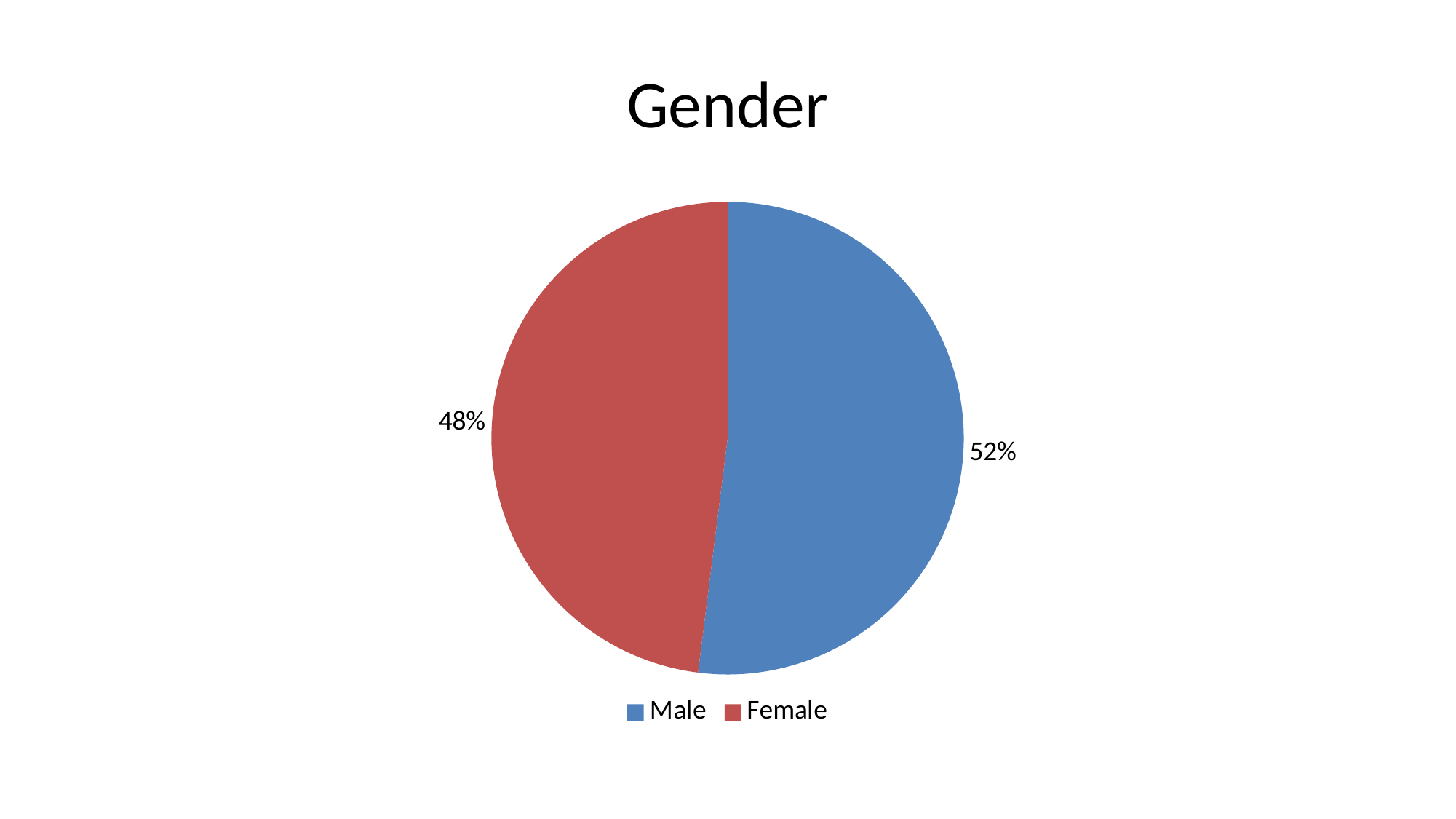
What percentage of the pie is Female? 48% Which is larger, the Male share or the Female share? Male What is the title of the chart? Gender Which category has the smallest share of the pie? Female What is the difference in percentage points between the Male and Female shares? 4% How many entries does the legend list? 2 What colour is the Female slice? red How many categories does the pie chart have? 2 What type of chart is shown on the slide? pie chart What is the share of the pie taken by the Male slice? 52% Which category has the largest share of the pie? Male What percentage of the pie is Male? 52%